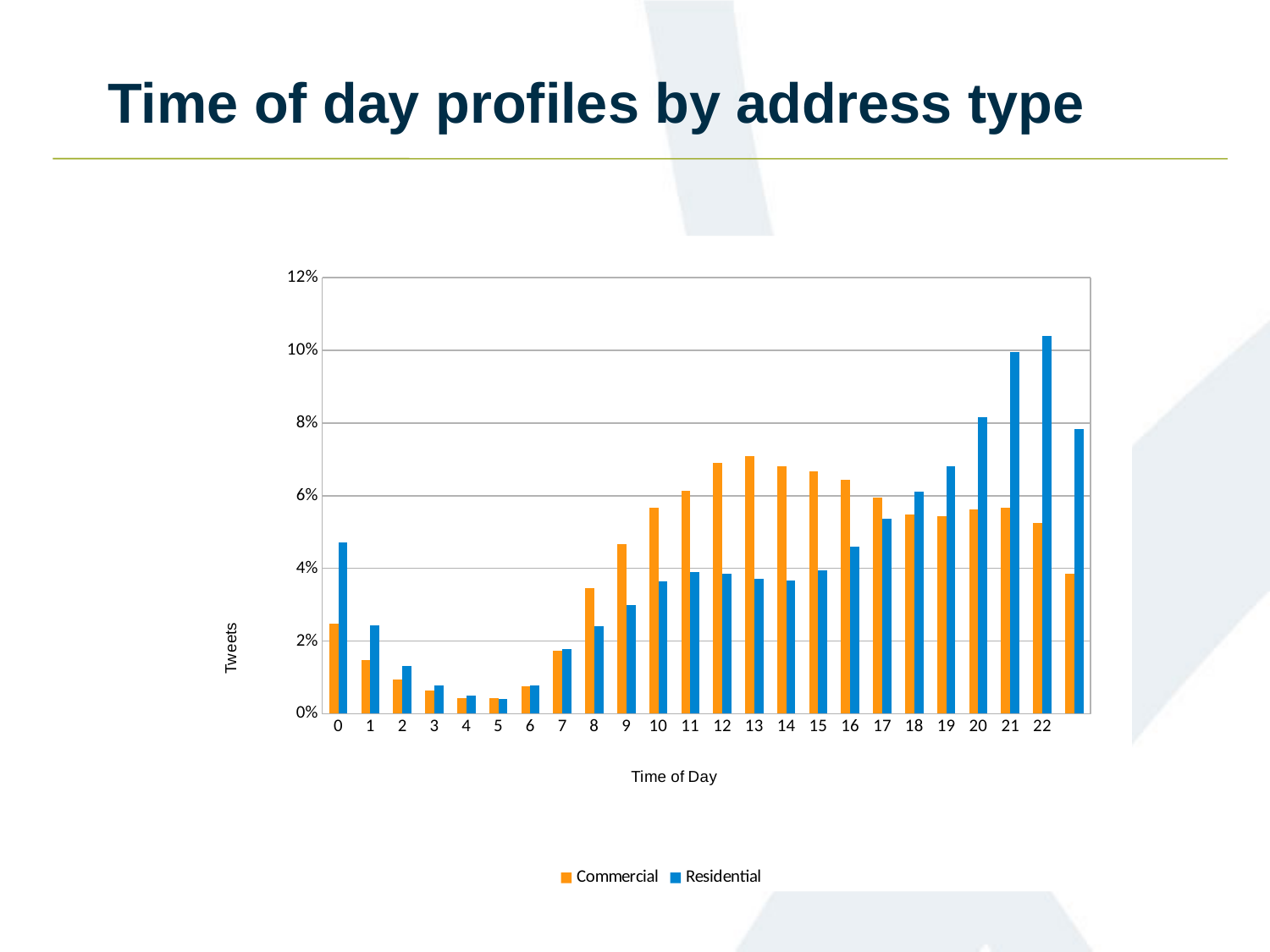
Is the Residential value at 22 greater or less than 10%? greater Is the Commercial value at 13 greater or less than 6%? greater At which time of day is the Residential value highest? 22 How many series does the legend list? 2 At time of day 12, which series has the larger value, Commercial or Residential? Commercial Is the Residential value at 0 greater or less than 4%? greater Do the Residential values rise or fall from time of day 17 to 22? rise What kind of chart is shown on the slide? bar chart What is the label of the vertical axis? Tweets At time of day 20, which series has the larger value, Commercial or Residential? Residential Which series is shown in orange? Commercial